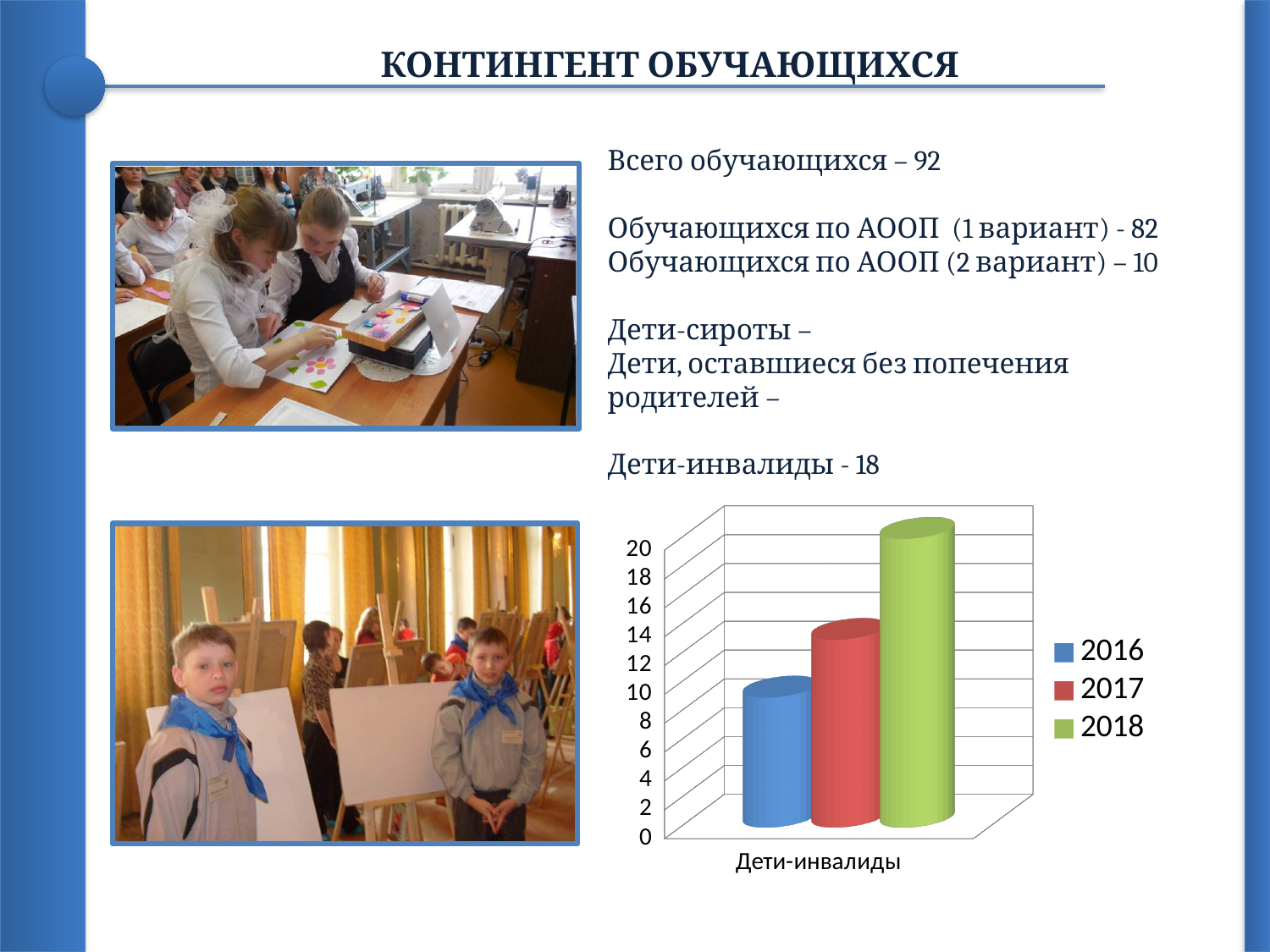
What kind of chart is shown on the slide? bar chart What is the category label shown on the x axis of the chart? Дети-инвалиды Which bar is taller, 2017 or 2016? 2017 Do the values rise or fall from 2016 to 2018? rise Which year has the lowest bar in the chart? 2016 How many categories are shown on the x axis of the chart? 1 Is the value for 2016 greater or less than 14? less Is the value for 2017 greater or less than 10? greater How many series does the chart legend list? 3 Is the value for 2018 greater or less than 14? greater Which year has the highest bar in the chart? 2018 Which bar is taller, 2017 or 2018? 2018